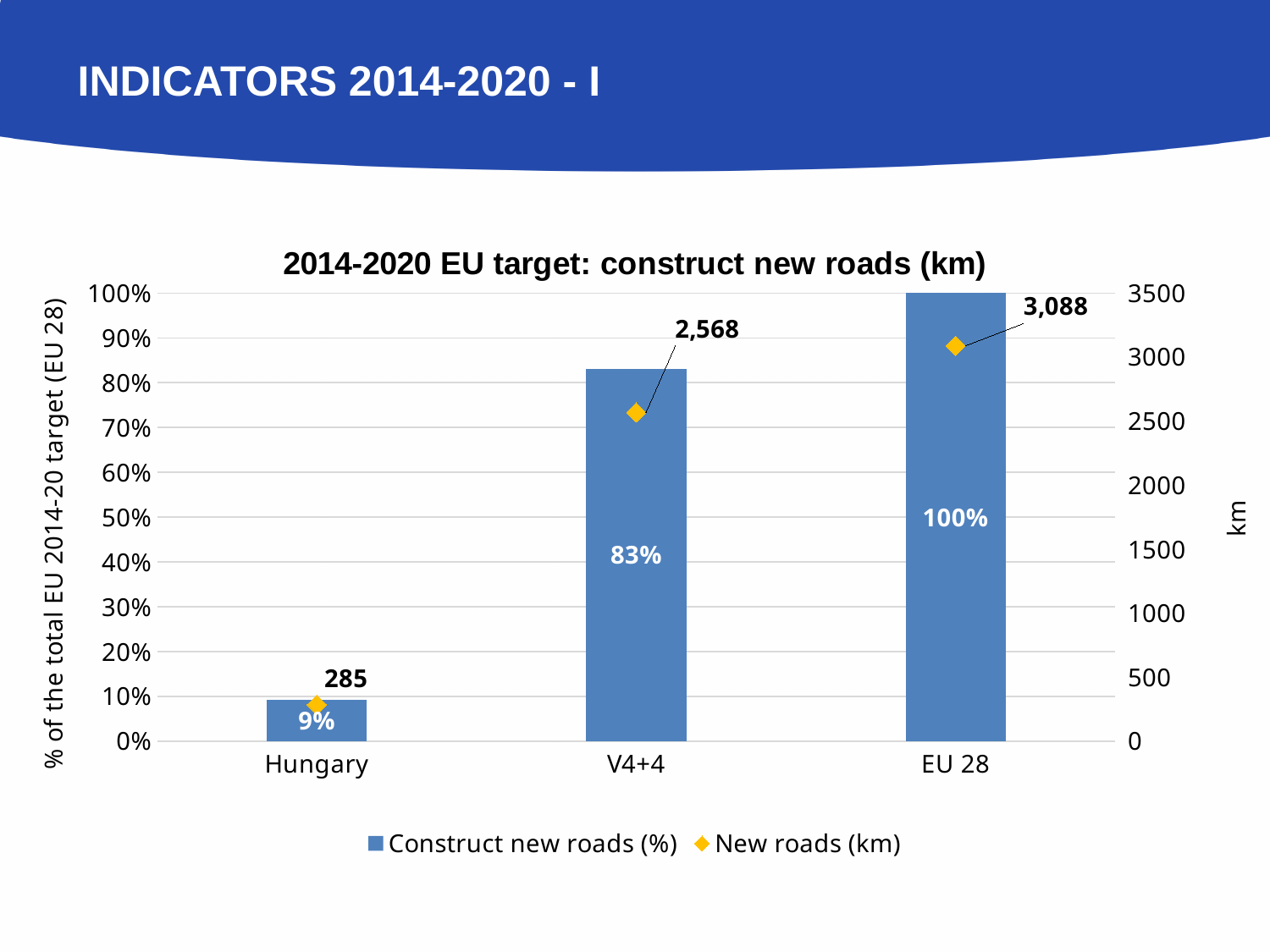
What is the 'Construct new roads (%)' value for V4+4? 83% Which category has the highest 'Construct new roads (%)' value? EU 28 What is the 'New roads (km)' value for V4+4? 2,568 How many series does the legend list? 2 What is the difference in 'New roads (km)' between EU 28 and V4+4? 520 Which category has the lowest 'New roads (km)' value? Hungary What is the 'New roads (km)' value for EU 28? 3,088 What is the 'Construct new roads (%)' value for Hungary? 9% What is the difference in 'Construct new roads (%)' between V4+4 and Hungary? 74% What is the title of the chart? 2014-2020 EU target: construct new roads (km) How many categories are shown on the x axis? 3 Which has a larger 'New roads (km)' value, Hungary or V4+4? V4+4